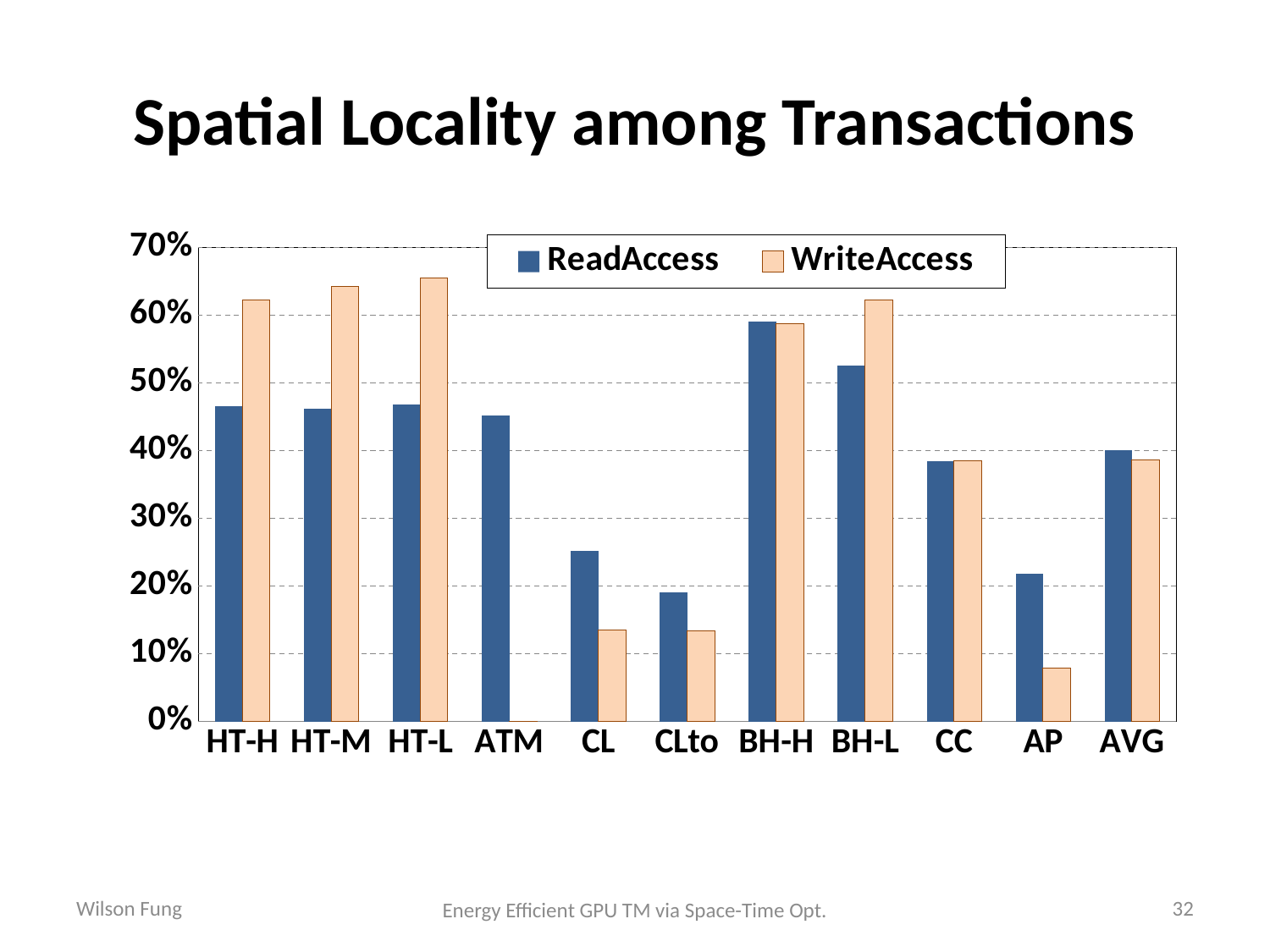
What kind of chart is shown on the slide? bar chart Is the WriteAccess value for AP greater or less than 10%? less Which category has the highest ReadAccess value? BH-H Which category has the lowest ReadAccess value? CLto For HT-H, which is larger: ReadAccess or WriteAccess? WriteAccess How many series does the legend list? 2 How many categories are shown on the x axis? 11 Is the WriteAccess value for HT-M greater or less than 60%? greater Which category has the lowest WriteAccess value? ATM For CL, which is larger: ReadAccess or WriteAccess? ReadAccess What is the title of the chart on the slide? Spatial Locality among Transactions Is the ReadAccess value for BH-H greater or less than 50%? greater